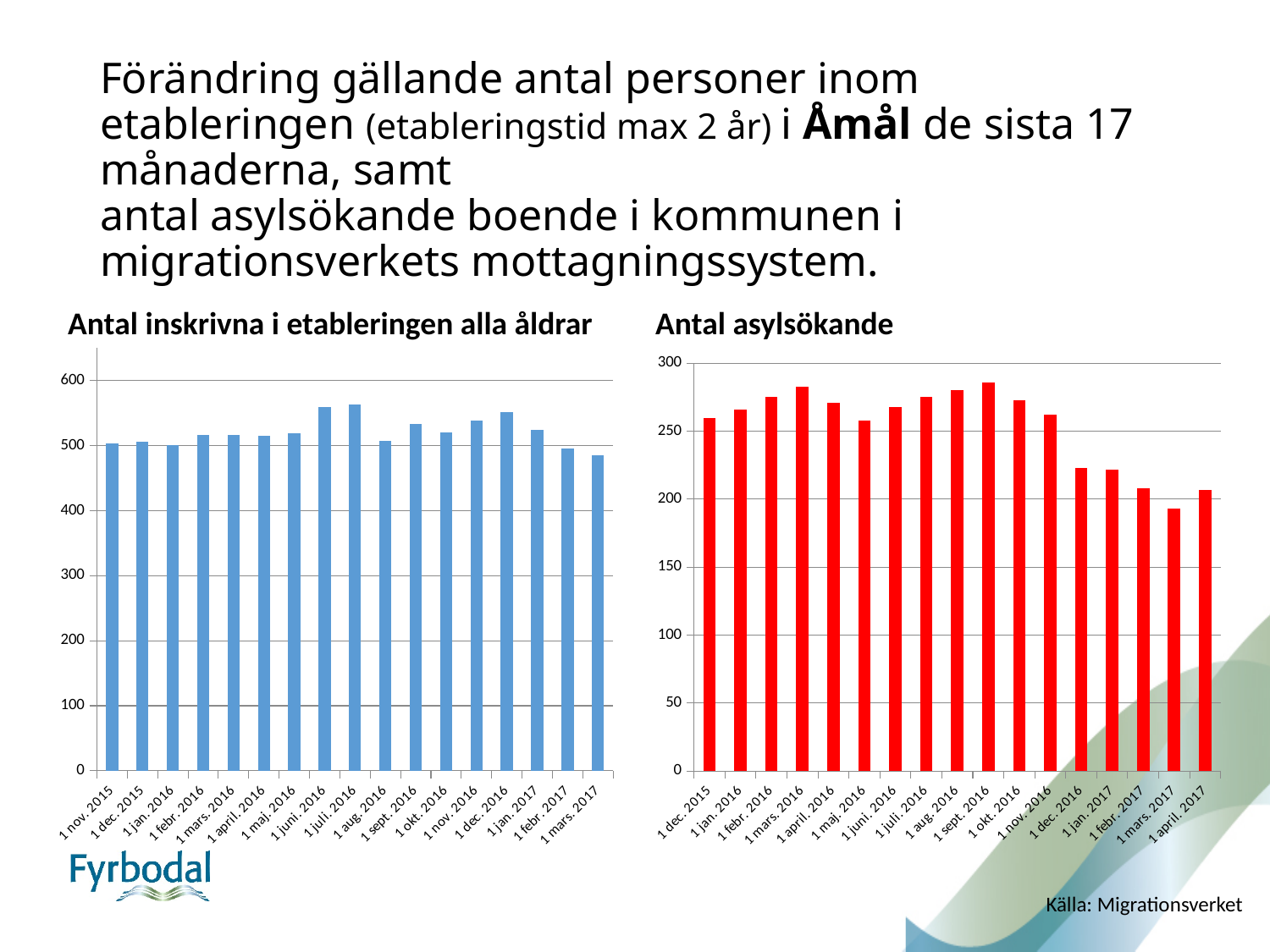
How many bars (months) are plotted in the 'Antal asylsökande' chart? 17 In the 'Antal inskrivna i etableringen alla åldrar' chart, which month has the lowest value? 1 mars. 2017 In the 'Antal asylsökande' chart, is the value for 1 mars. 2017 greater or less than 200? less In the 'Antal asylsökande' chart, which month has the lowest value? 1 mars. 2017 What colour are the bars in the 'Antal asylsökande' chart? red What kind of chart is the 'Antal asylsökande' chart on the right? bar chart In the 'Antal inskrivna i etableringen alla åldrar' chart, is the value for 1 juli. 2016 greater or less than 500? greater In the 'Antal asylsökande' chart, which is larger: the value for 1 sept. 2016 or the value for 1 jan. 2017? 1 sept. 2016 In the 'Antal asylsökande' chart, is the value for 1 dec. 2016 greater or less than 250? less How many bars (months) are plotted in the 'Antal inskrivna i etableringen alla åldrar' chart? 17 In the 'Antal asylsökande' chart, do the values overall rise or fall from 1 dec. 2015 to 1 april. 2017? fall